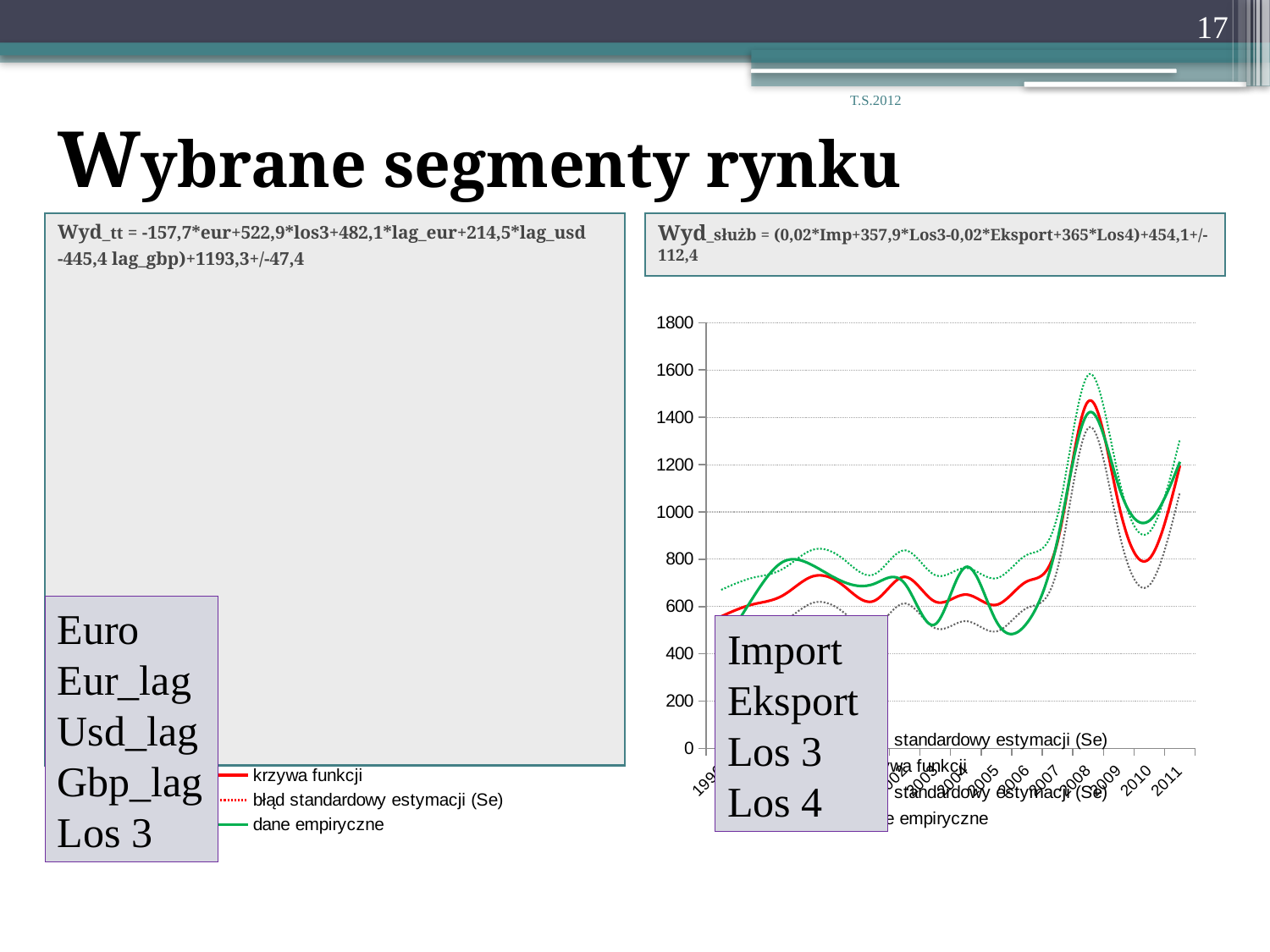
On the right chart, is the lowest value of the green 'dane empiryczne' line around 2006 greater or less than 600? less On the right chart, is the peak value of the green 'dane empiryczne' line around 2008 greater or less than 1200? greater On the right chart, is the value of the red 'krzywa funkcji' line at the start of the series greater or less than 800? less How many series does the legend of the right chart list? 4 On the right chart, do the values of the red 'krzywa funkcji' line overall rise or fall from the start of the series to the end? rise On the right chart, which colour is used for the 'dane empiryczne' series? green What kind of chart is the chart on the right side of the slide? line chart On the right chart, which is larger around 2008: the peak of the red 'krzywa funkcji' line or the value of the green 'dane empiryczne' line at the start of the series? the peak of the red 'krzywa funkcji' line On the right chart, what is the highest value shown on the vertical axis? 1800 How many series does the legend of the left chart list? 3